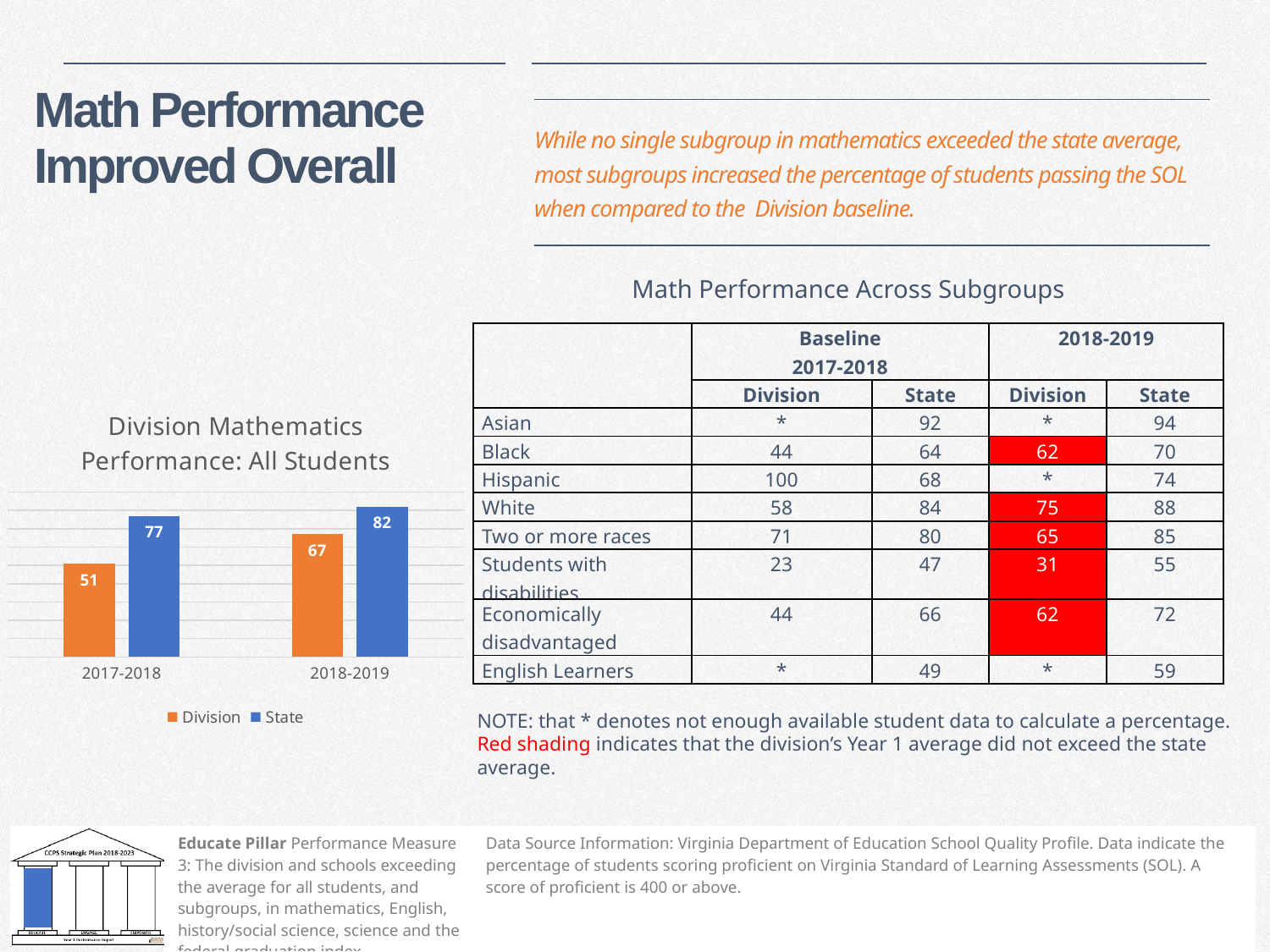
What is the Division value for 2018-2019 in the Division Mathematics Performance: All Students chart? 67 What is the State value for 2018-2019 in the Division Mathematics Performance: All Students chart? 82 What kind of chart is the Division Mathematics Performance: All Students chart? bar chart How many series does the legend list in the Division Mathematics Performance: All Students chart? 2 In the Division Mathematics Performance: All Students chart, is the Division value for 2017-2018 larger or smaller than the State value for 2017-2018? smaller Which bar is the highest in the Division Mathematics Performance: All Students chart? State, 2018-2019 In the Division Mathematics Performance: All Students chart, by how much did the Division value increase from 2017-2018 to 2018-2019? 16 In the Division Mathematics Performance: All Students chart, what is the difference between the State and Division values for 2018-2019? 15 In the Division Mathematics Performance: All Students chart, do the Division values rise or fall from 2017-2018 to 2018-2019? rise What is the State value for 2017-2018 in the Division Mathematics Performance: All Students chart? 77 Which bar is the lowest in the Division Mathematics Performance: All Students chart? Division, 2017-2018 What is the Division value for 2017-2018 in the Division Mathematics Performance: All Students chart? 51